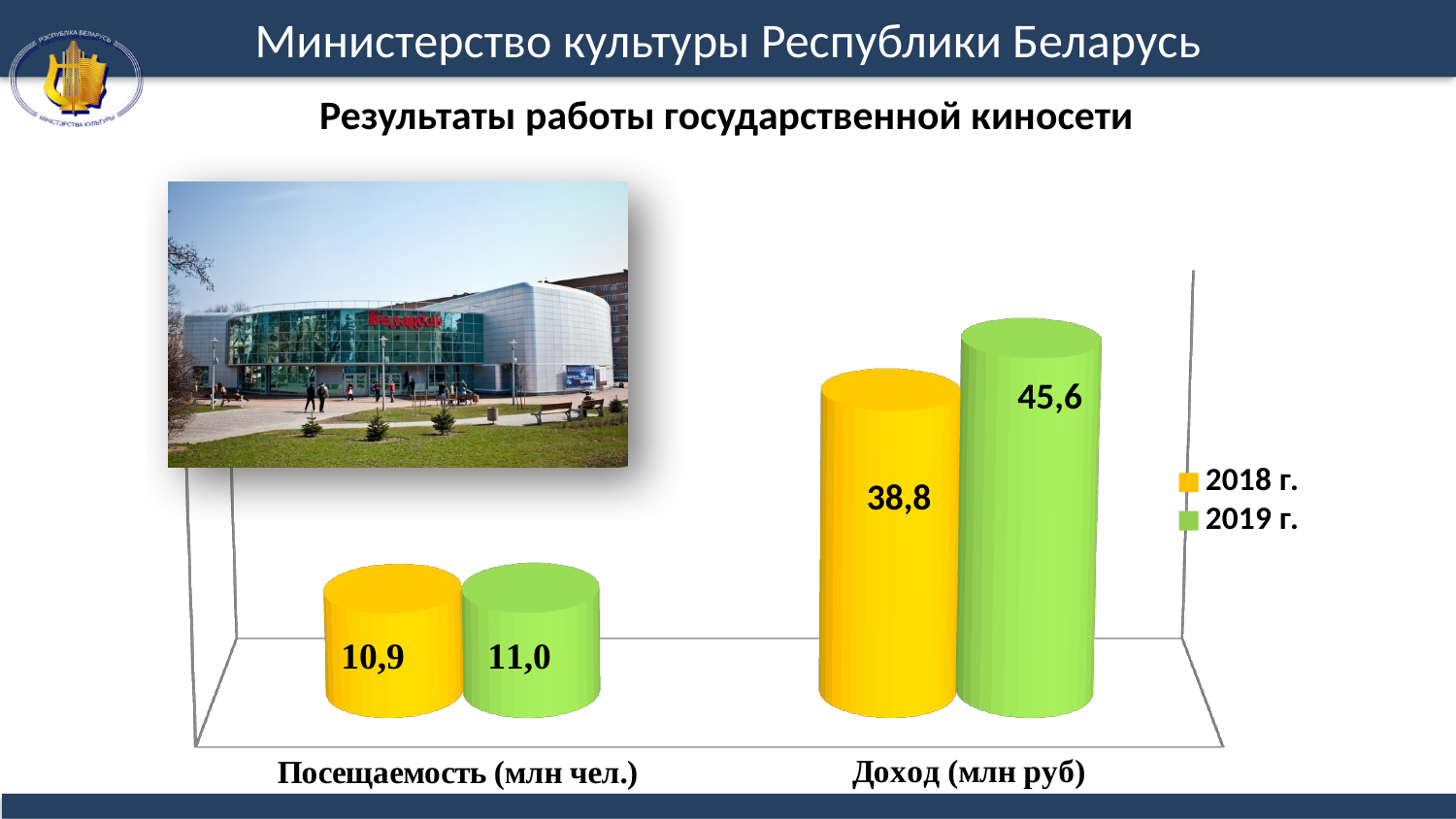
How many categories are shown on the x axis of the chart? 2 What was the value for Посещаемость (млн чел.) in 2018 г.? 10,9 What was the value for Доход (млн руб) in 2018 г.? 38,8 What kind of chart is shown on the slide? Bar chart What was the value for Доход (млн руб) in 2019 г.? 45,6 Which category has the highest plotted value on the chart? Доход (млн руб) Which year has the higher value for Доход (млн руб), 2018 г. or 2019 г.? 2019 г. What is the difference between the 2019 г. and 2018 г. values for Посещаемость (млн чел.)? 0,1 How many series does the legend list? 2 What was the value for Посещаемость (млн чел.) in 2019 г.? 11,0 By how much did Доход (млн руб) increase from 2018 г. to 2019 г.? 6,8 Which bar is the lowest on the chart? Посещаемость (млн чел.) in 2018 г.